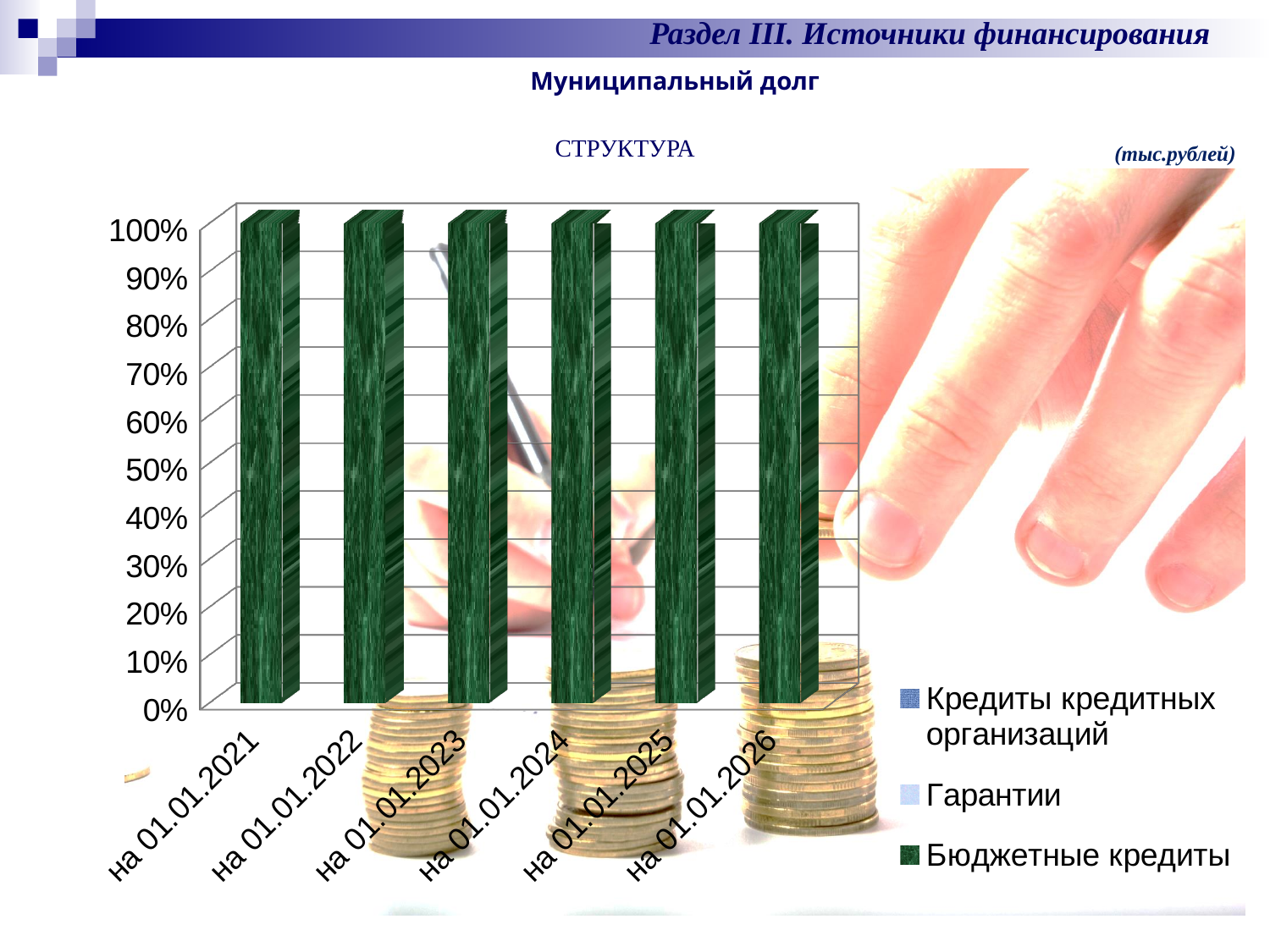
What is the highest value shown on the vertical axis of the chart? 100% How many series does the chart legend list? 3 Is the value for Бюджетные кредиты at на 01.01.2026 greater or less than 90%? greater Is the value for Бюджетные кредиты at на 01.01.2023 greater or less than 50%? greater What is the first category on the x axis of the chart? на 01.01.2021 Which legend entry is shown in dark green? Бюджетные кредиты What is the title shown above the chart? СТРУКТУРА What is the total height of the stacked bar for на 01.01.2021? 100% What kind of chart is shown on the slide? bar chart What is the last category on the x axis of the chart? на 01.01.2026 How many dates (categories) are shown along the x axis of the chart? 6 Do the bar heights rise, fall, or stay the same from на 01.01.2021 to на 01.01.2026? stay the same